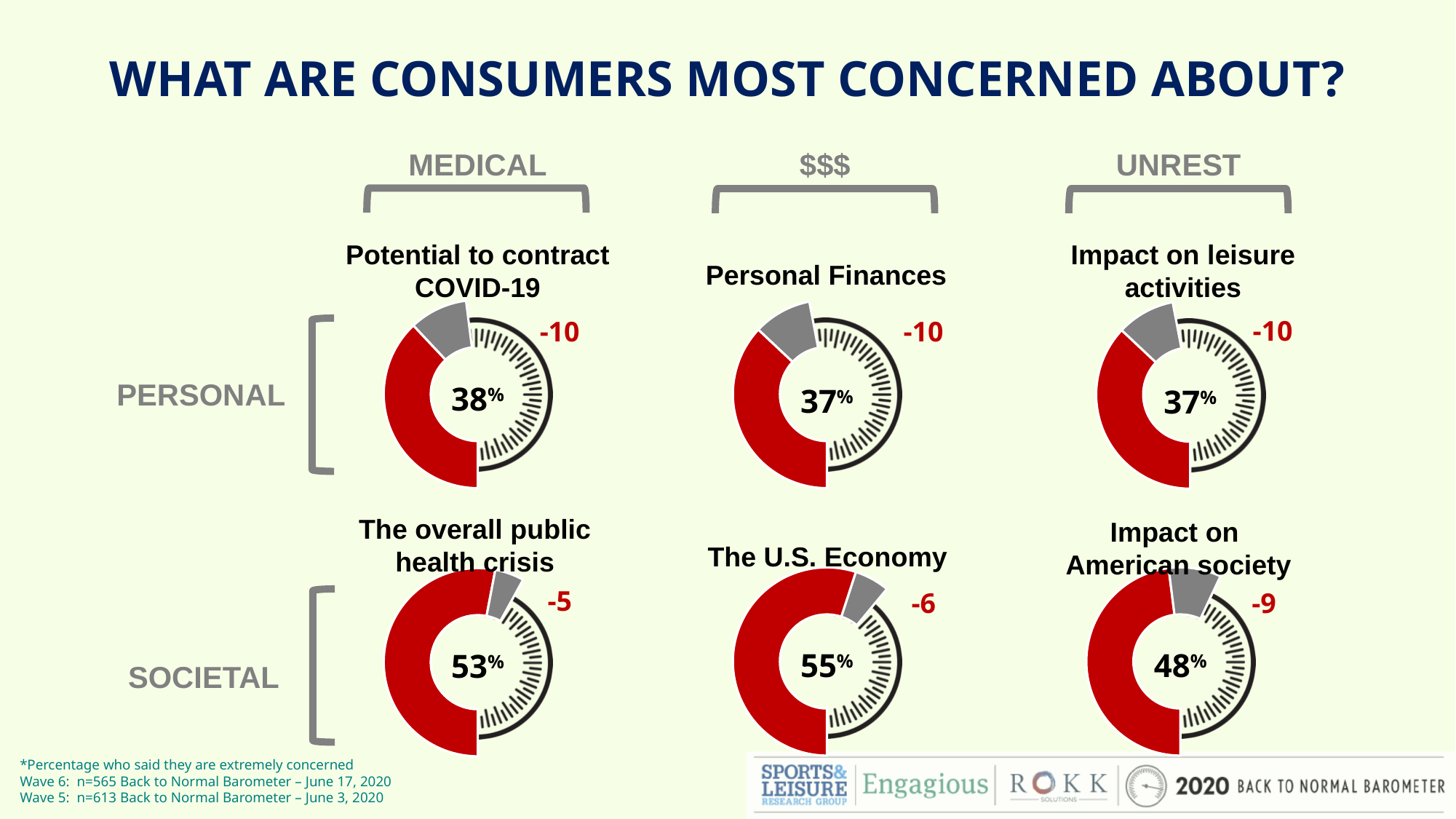
What is the difference in percentage points between The U.S. Economy gauge and the Personal Finances gauge? 18 Which of the six concerns has the highest percentage of extremely concerned consumers? The U.S. Economy What percentage is shown in the Personal Finances gauge? 37% How many gauge charts are shown on the slide? 6 Which of the six concerns has the lowest percentage of extremely concerned consumers? Personal Finances and Impact on leisure activities (37%) What percentage is shown in the gauge for Impact on American society? 48% Which is larger: the percentage for The overall public health crisis or the percentage for Impact on American society? The overall public health crisis What change from the previous wave is shown next to the gauge for The overall public health crisis? -5 What percentage is shown in the gauge for The U.S. Economy? 55% What percentage of consumers are extremely concerned about the potential to contract COVID-19? 38% Which concern shows the smallest decline from the previous wave? The overall public health crisis (-5) What kind of chart is used to show each concern's percentage? Gauge (donut) chart